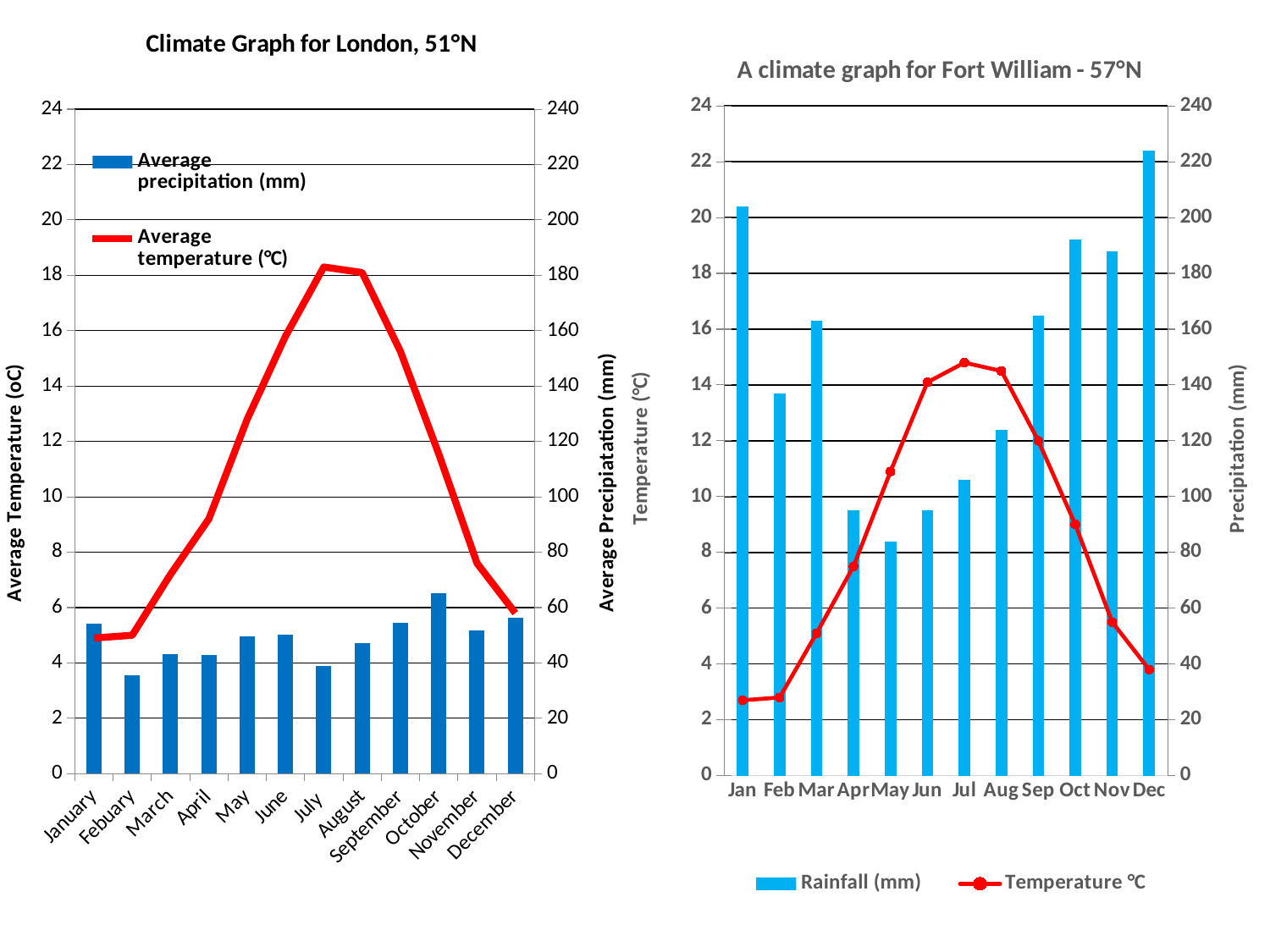
In the climate graph for Fort William, does the temperature line rise or fall from Jan to Jul? rise In the Climate Graph for London, how many months are shown on the x axis? 12 In the climate graph for Fort William, is the rainfall for May greater or less than 100? less In the Climate Graph for London, which month has the lowest average precipitation bar? Febuary In the climate graph for Fort William, which month has the highest rainfall bar? Dec In the Climate Graph for London, is the average temperature for July greater or less than 16? greater In the Climate Graph for London, is the average precipitation for October greater or less than 60? greater In the Climate Graph for London, how many series does the legend list? 2 In the Climate Graph for London, which month has the highest average precipitation bar? October In the Climate Graph for London, in which month does the average temperature line reach its peak? July In the climate graph for Fort William, which month has the lowest rainfall bar? May In the climate graph for Fort William, what colour are the rainfall bars? Light blue